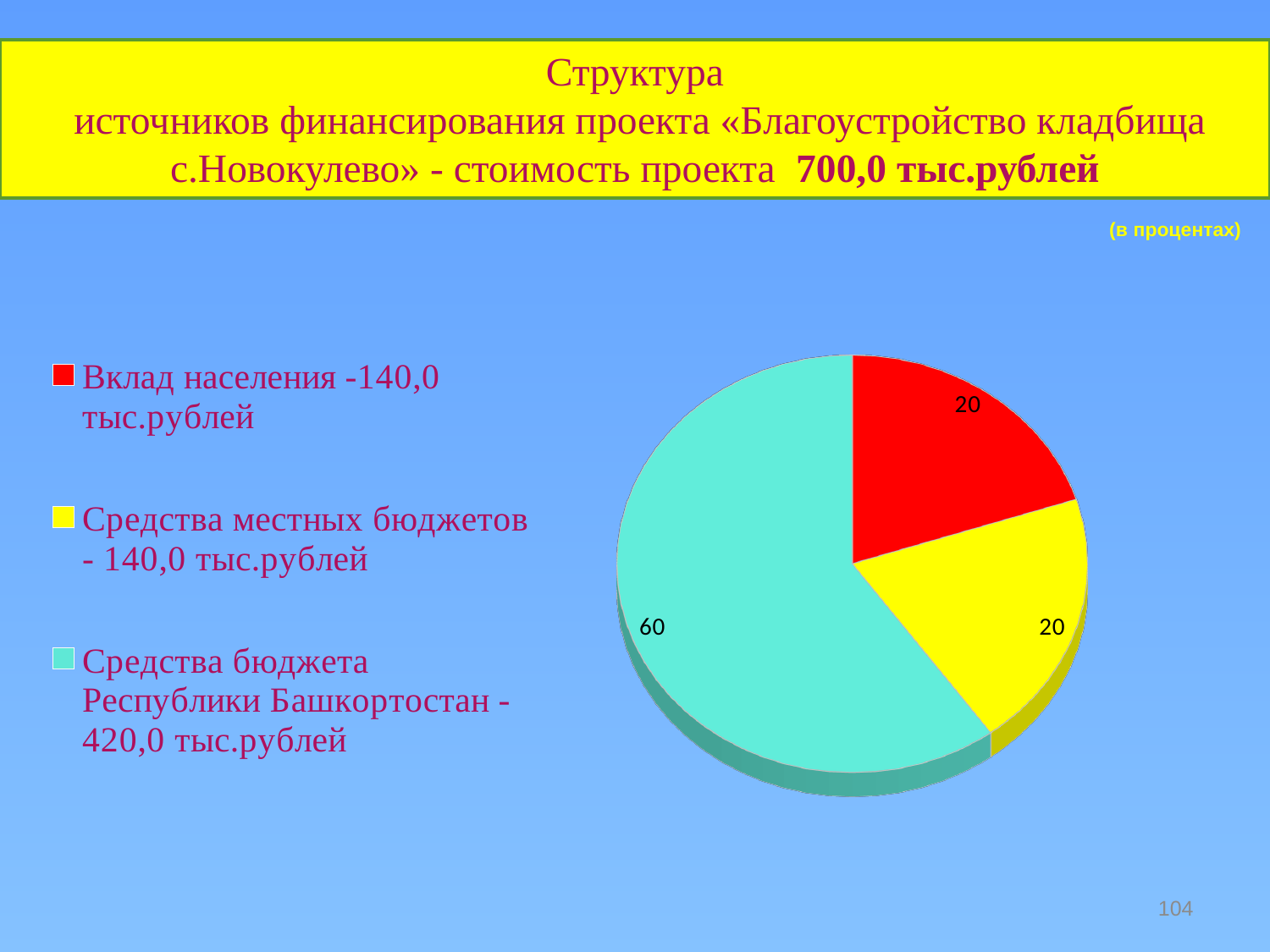
According to the legend, what amount in тыс.рублей corresponds to "Средства бюджета Республики Башкортостан"? 420,0 тыс.рублей What share of the pie does the "Средства бюджета Республики Башкортостан" slice represent, in percent? 60 Which funding source has the largest slice of the pie? Средства бюджета Республики Башкортостан What value is shown for the slice "Вклад населения"? 20 Which is larger: the slice for "Средства бюджета Республики Башкортостан" or the slice for "Средства местных бюджетов"? Средства бюджета Республики Башкортостан What kind of chart is shown on the slide? pie chart What colour is the slice for "Вклад населения"? red What is the difference between the value for "Средства бюджета Республики Башкортостан" and the value for "Вклад населения"? 40 What is the sum of the three values shown on the pie chart? 100 How many slices does the pie chart have? 3 What value is shown for the slice "Средства местных бюджетов"? 20 What value is shown for the slice "Средства бюджета Республики Башкортостан"? 60